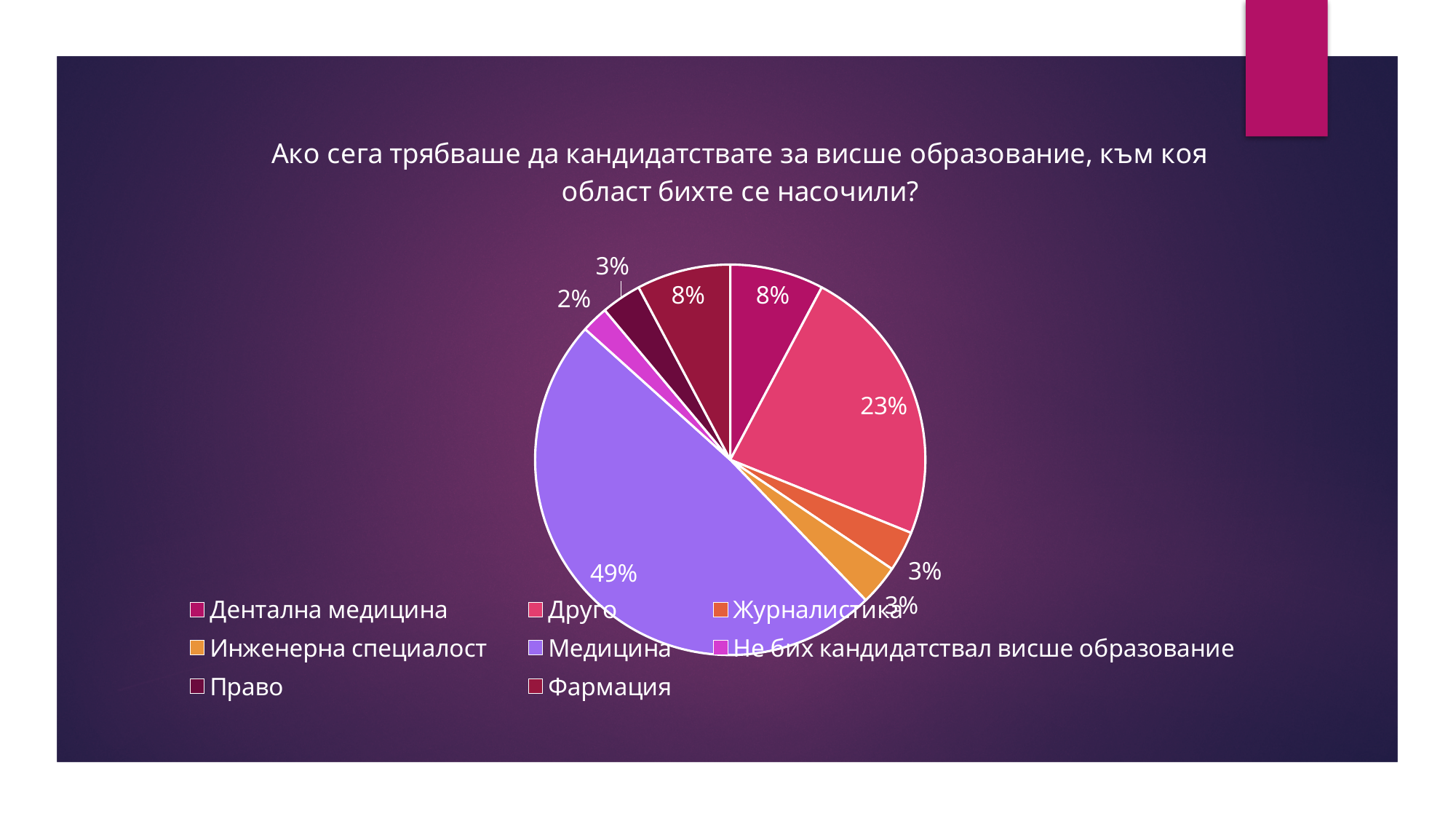
What share of the pie does Друго have? 23% What is the title of the chart? Ако сега трябваше да кандидатствате за висше образование, към коя област бихте се насочили? What share of the pie does Не бих кандидатствал висше образование have? 2% What is the difference in percentage points between Медицина and Друго? 26 What share of the pie does Медицина have? 49% Which category has the smallest slice of the pie? Не бих кандидатствал висше образование Which category has the largest slice of the pie? Медицина How many categories does the pie chart have? 8 What share of the pie does Дентална медицина have? 8% What kind of chart is shown on the slide? pie chart What share of the pie does Фармация have? 8% Which is larger, the slice for Друго or the slice for Фармация? Друго